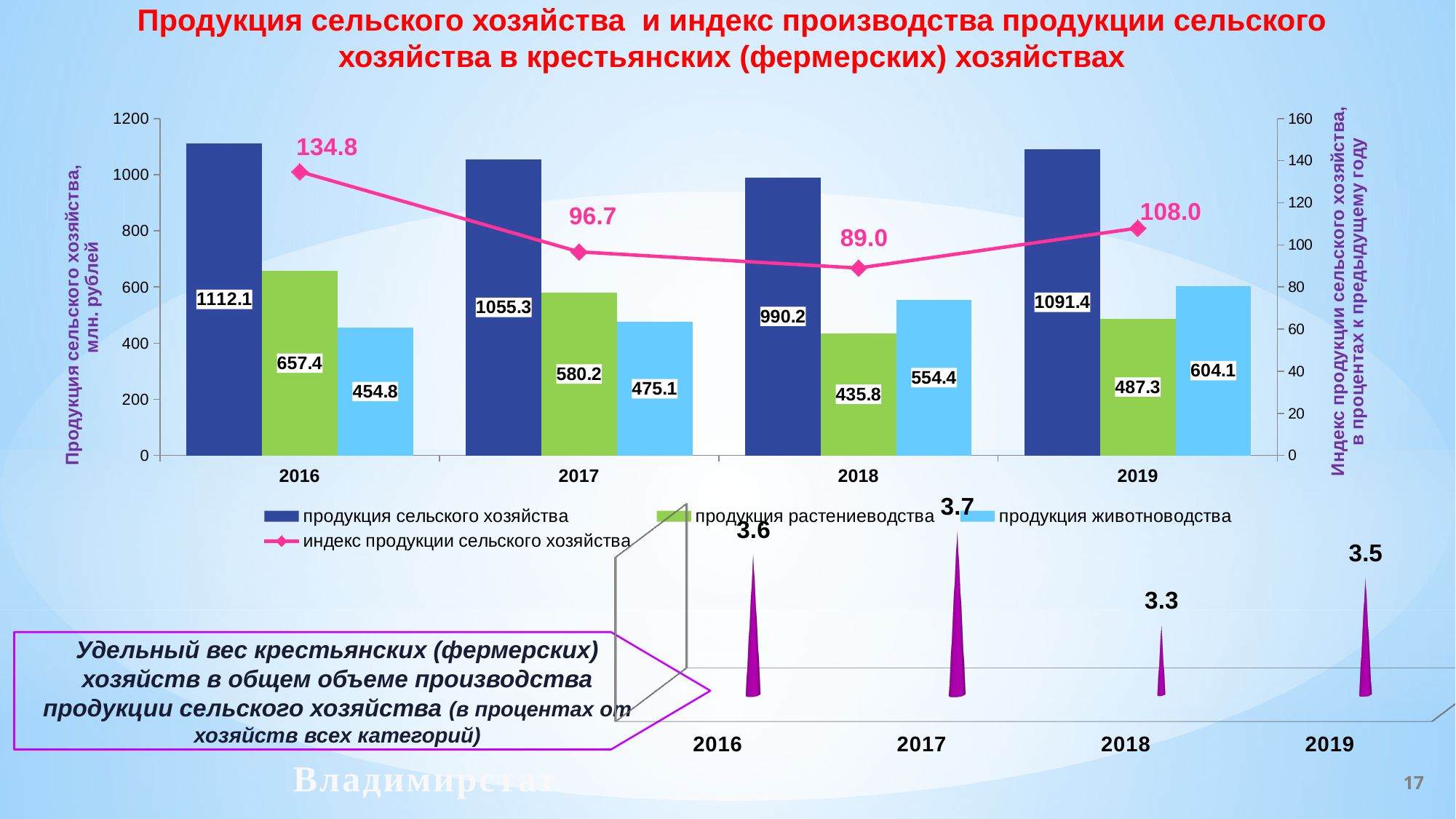
In the bottom chart (Удельный вес крестьянских (фермерских) хозяйств), which year has the lowest value? 2018 In the bottom chart (Удельный вес крестьянских (фермерских) хозяйств), what is the value for 2017? 3.7 In the top chart, what is the difference between продукция растениеводства in 2016 and in 2017? 77.2 In the top chart, which is larger in 2018: продукция растениеводства or продукция животноводства? продукция животноводства In the top chart, what is the value of продукция животноводства for 2019? 604.1 In the top chart, how does индекс продукции сельского хозяйства change from 2016 to 2018? It falls In the top chart, in which year is продукция сельского хозяйства highest? 2016 In the top chart, what is the value of индекс продукции сельского хозяйства for 2016? 134.8 In the top chart, in which year is продукция растениеводства lowest? 2018 In the top chart, what is the value of продукция сельского хозяйства for 2018? 990.2 In the top chart, how many series does the legend list? 4 In the bottom chart (Удельный вес крестьянских (фермерских) хозяйств), how many years are shown? 4